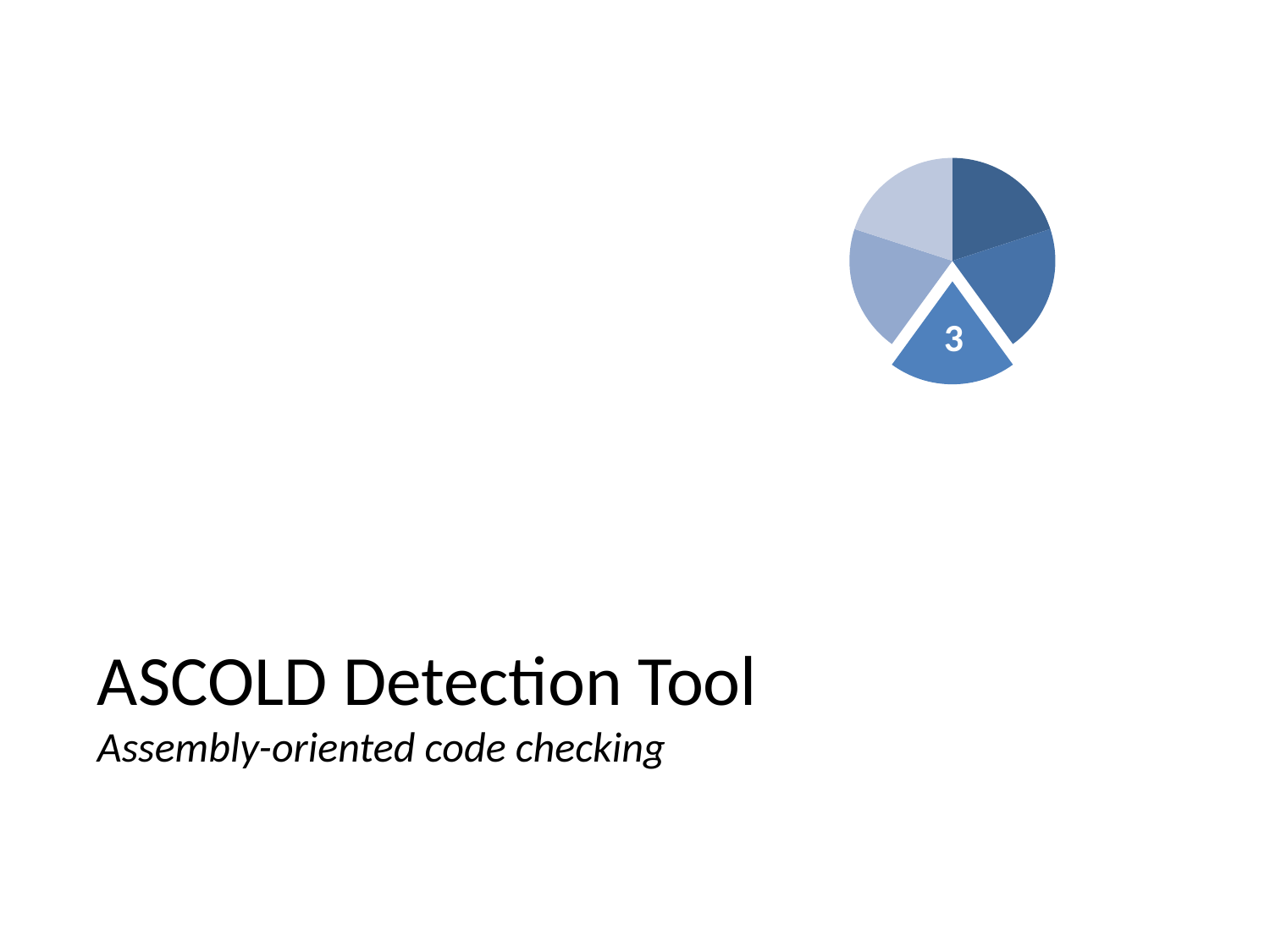
Does the pie chart have a legend? No How many slices of the pie chart are pulled out (exploded) from the rest? 1 What kind of chart is shown on the slide? pie chart How many slices does the pie chart have? 5 What label is printed on the slice that is pulled out from the pie chart? 3